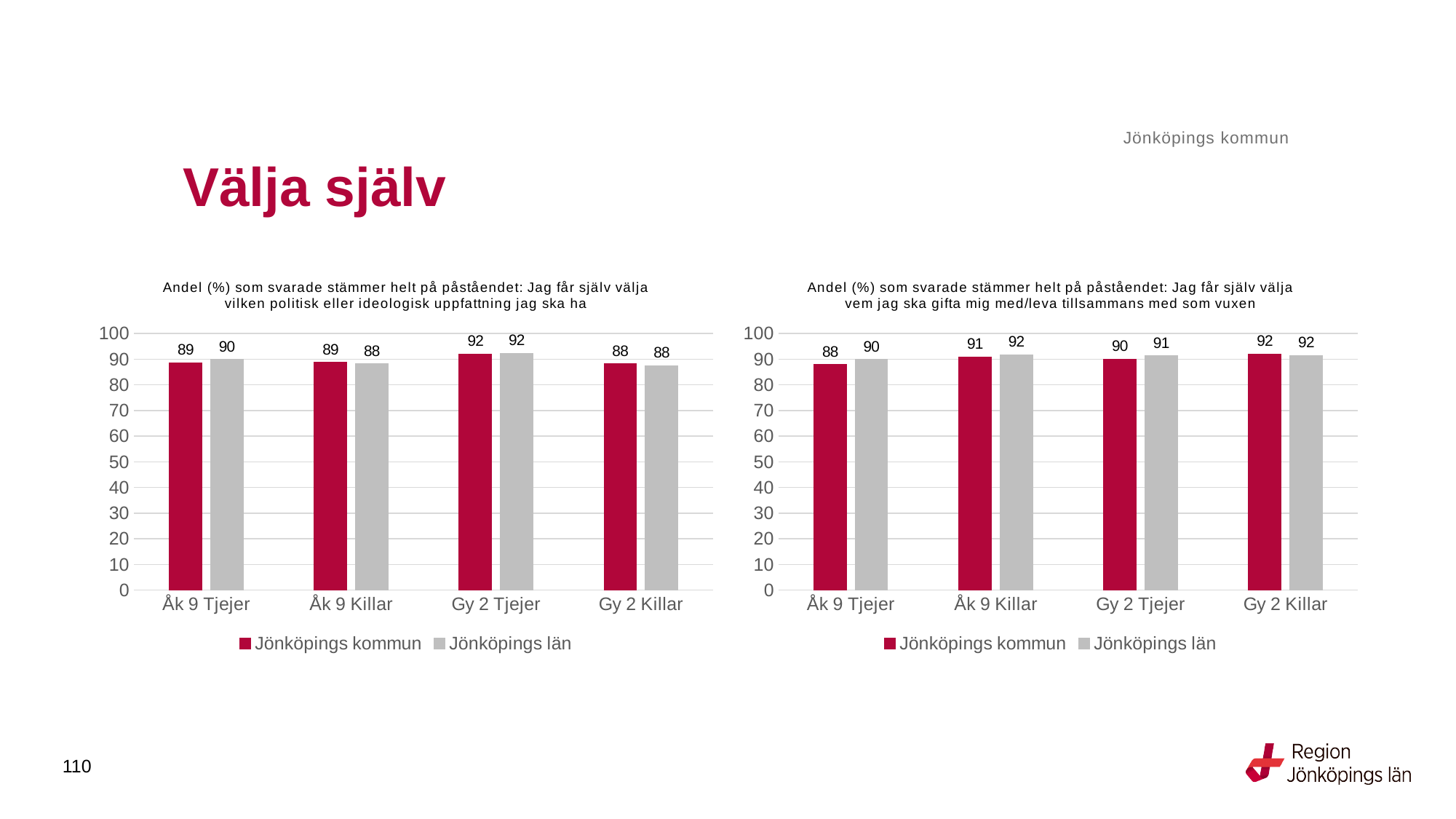
In the left chart (political or ideological opinion), which category has the highest value for Jönköpings kommun? Gy 2 Tjejer How many categories are shown on the x axis of the left chart? 4 In the right chart (whom to marry/live with), which category has the lowest value for Jönköpings kommun? Åk 9 Tjejer In the left chart (political or ideological opinion), what is the value for Jönköpings kommun for Åk 9 Tjejer? 89 In the right chart (whom to marry/live with), what is the difference between the Jönköpings län values for Åk 9 Killar and Åk 9 Tjejer? 2 In the left chart (political or ideological opinion), what is the difference between the Jönköpings kommun values for Gy 2 Tjejer and Gy 2 Killar? 4 In the left chart (political or ideological opinion), what is the value for Jönköpings län for Gy 2 Tjejer? 92 In the right chart (whom to marry/live with), what is the value for Jönköpings län for Åk 9 Tjejer? 90 In the right chart (whom to marry/live with), what is the value for Jönköpings kommun for Gy 2 Tjejer? 90 How many series does the legend of the right chart list? 2 What kind of chart is the left chart? Bar chart In the right chart (whom to marry/live with), which is larger for Åk 9 Killar: Jönköpings kommun or Jönköpings län? Jönköpings län